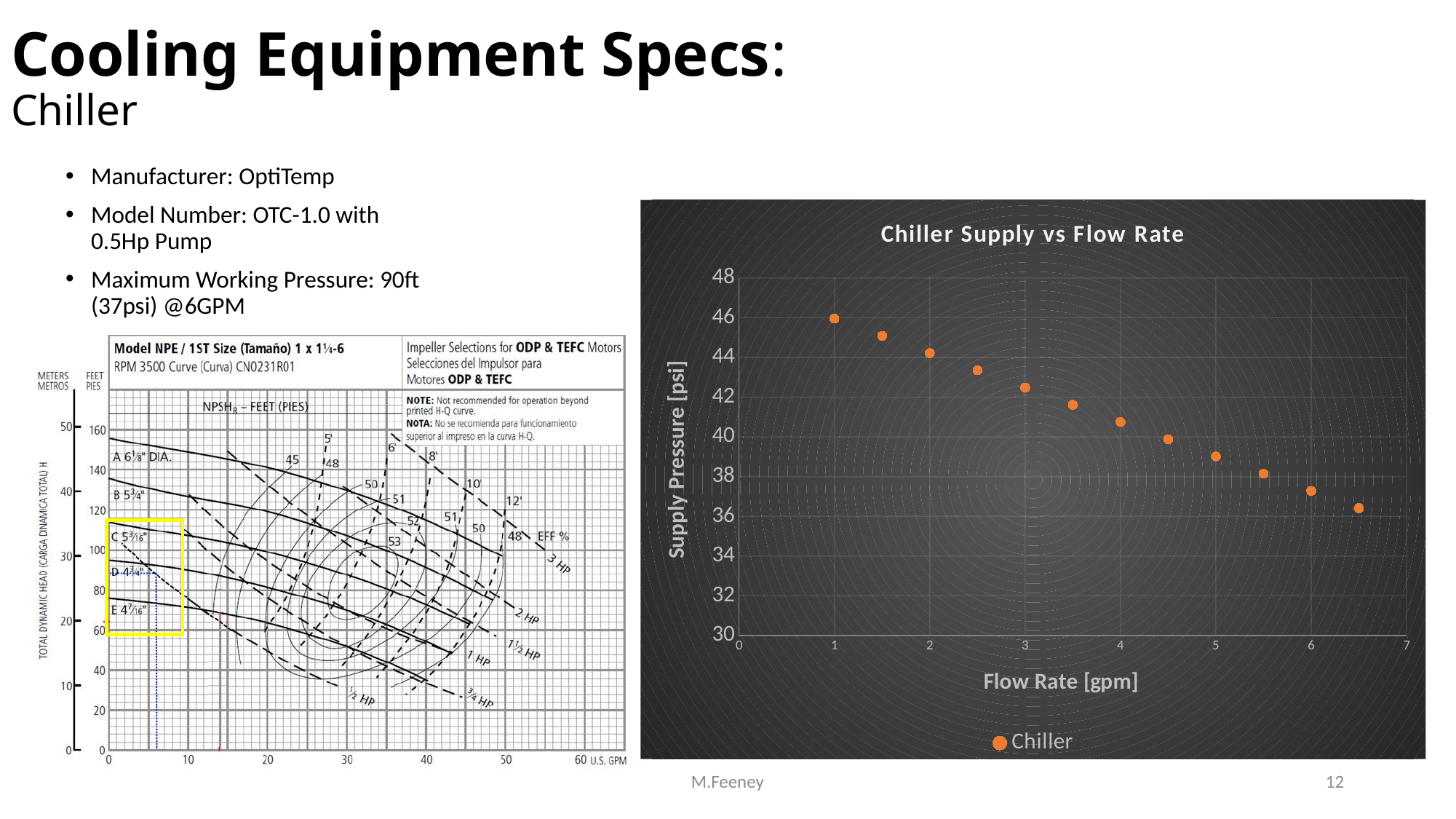
In the "Chiller Supply vs Flow Rate" chart, which has the higher supply pressure: a flow rate of 2 gpm or 5 gpm? 2 gpm In the "Chiller Supply vs Flow Rate" chart, is the supply pressure at a flow rate of 3 gpm greater or less than 40? greater In the "Chiller Supply vs Flow Rate" chart, is the supply pressure at a flow rate of 1 gpm greater or less than 44? greater How many data points are plotted in the "Chiller Supply vs Flow Rate" chart? 12 What kind of chart is "Chiller Supply vs Flow Rate"? scatter chart In the "Chiller Supply vs Flow Rate" chart, do the supply pressure values rise or fall as flow rate increases? fall What is the y-axis title of the "Chiller Supply vs Flow Rate" chart? Supply Pressure [psi] In the "Chiller Supply vs Flow Rate" chart, at which flow rate is the supply pressure highest? 1 gpm How many series does the legend of the "Chiller Supply vs Flow Rate" chart list? 1 In the "Chiller Supply vs Flow Rate" chart, is the supply pressure at a flow rate of 6 gpm greater or less than 38? less In the "Chiller Supply vs Flow Rate" chart, at which flow rate is the supply pressure lowest? 6.5 gpm What is the legend entry shown on the "Chiller Supply vs Flow Rate" chart? Chiller